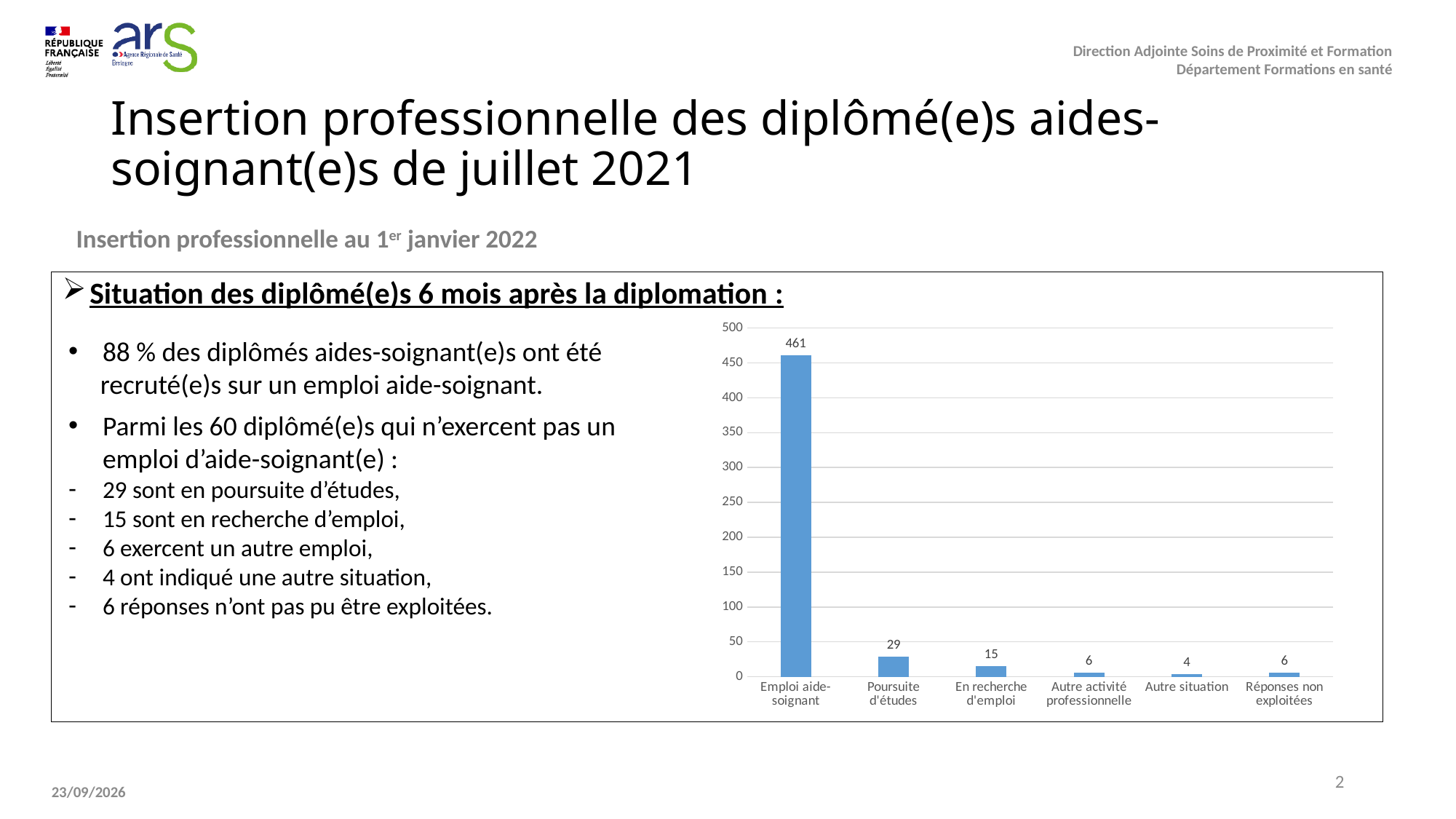
Is the value for "Emploi aide-soignant" greater or less than 400? greater Which category has the lowest value? Autre situation Which is larger, the value for "Poursuite d'études" or the value for "En recherche d'emploi"? Poursuite d'études How many categories are shown on the x axis of the chart? 6 What is the value for "En recherche d'emploi"? 15 What is the value for "Emploi aide-soignant"? 461 What is the value for "Autre situation"? 4 Which category has the highest value? Emploi aide-soignant What is the difference between the values for "Emploi aide-soignant" and "Poursuite d'études"? 432 What kind of chart is shown on the slide? bar chart What is the value for "Poursuite d'études"? 29 What is the difference between the values for "Poursuite d'études" and "En recherche d'emploi"? 14